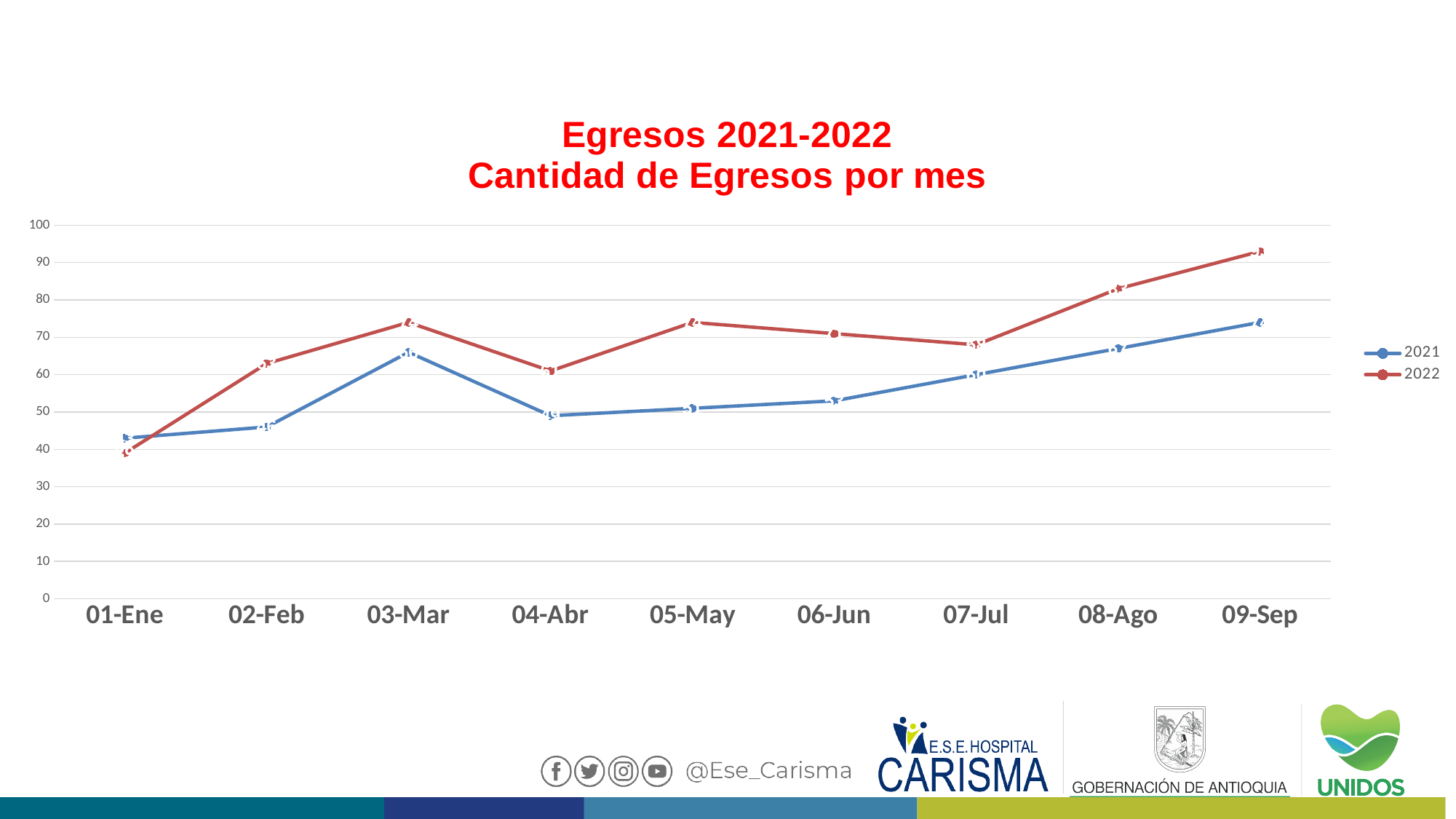
What kind of chart is shown on the slide? Line chart How many months are plotted along the x axis? 9 In which month does the 2022 series have its lowest value? 01-Ene In which month does the 2022 series reach its highest value? 09-Sep Which series has the higher value in 03-Mar, 2021 or 2022? 2022 In which month does the 2021 series reach its highest value? 09-Sep What is the title of the chart? Egresos 2021-2022 Cantidad de Egresos por mes Is the value for 2022 in 08-Ago greater or less than 80? greater Is the value for 2022 in 09-Sep greater or less than 90? greater How many series does the legend list? 2 Does the 2021 series rise or fall from 04-Abr to 09-Sep? Rise Is the value for 2021 in 03-Mar greater or less than 60? greater